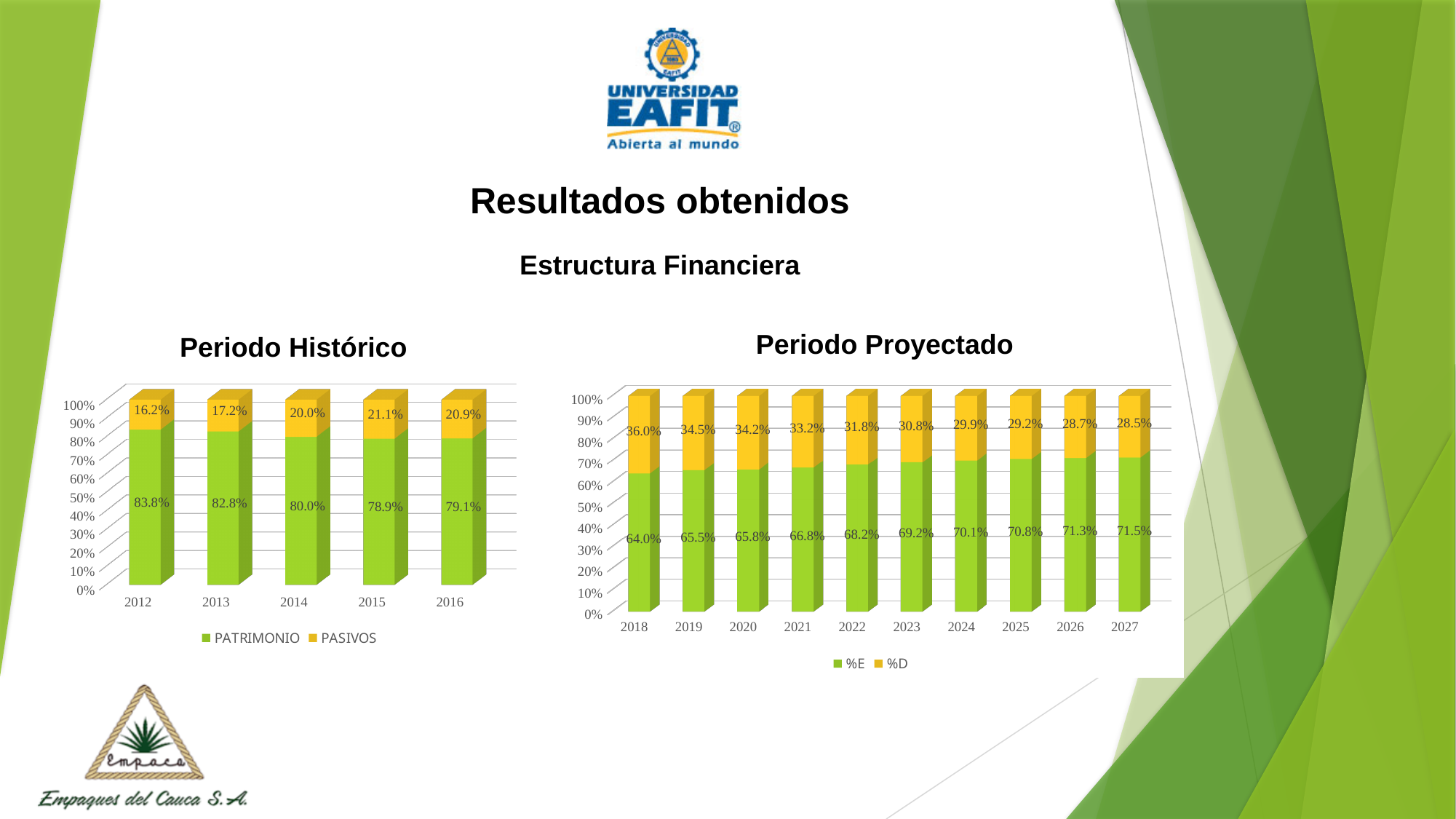
In the Periodo Proyectado chart, how many series does the legend list? 2 In the Periodo Histórico chart, which year has the lowest PATRIMONIO value? 2015 What kind of chart is the Periodo Histórico chart? stacked bar chart In the Periodo Histórico chart, what is the PASIVOS value for 2015? 21.1% In the Periodo Proyectado chart, what is the %E value for 2022? 68.2% In the Periodo Histórico chart, what is the PATRIMONIO value for 2012? 83.8% In the Periodo Proyectado chart, what is the difference between the %E values for 2027 and 2018? 7.5% In the Periodo Proyectado chart, what is the %D value for 2027? 28.5% In the Periodo Histórico chart, which year has the highest PASIVOS value? 2015 In the Periodo Histórico chart, how many years are shown on the x axis? 5 In the Periodo Proyectado chart, does the %E value rise or fall from 2018 to 2027? rise In the Periodo Proyectado chart, which year has the highest %D value? 2018